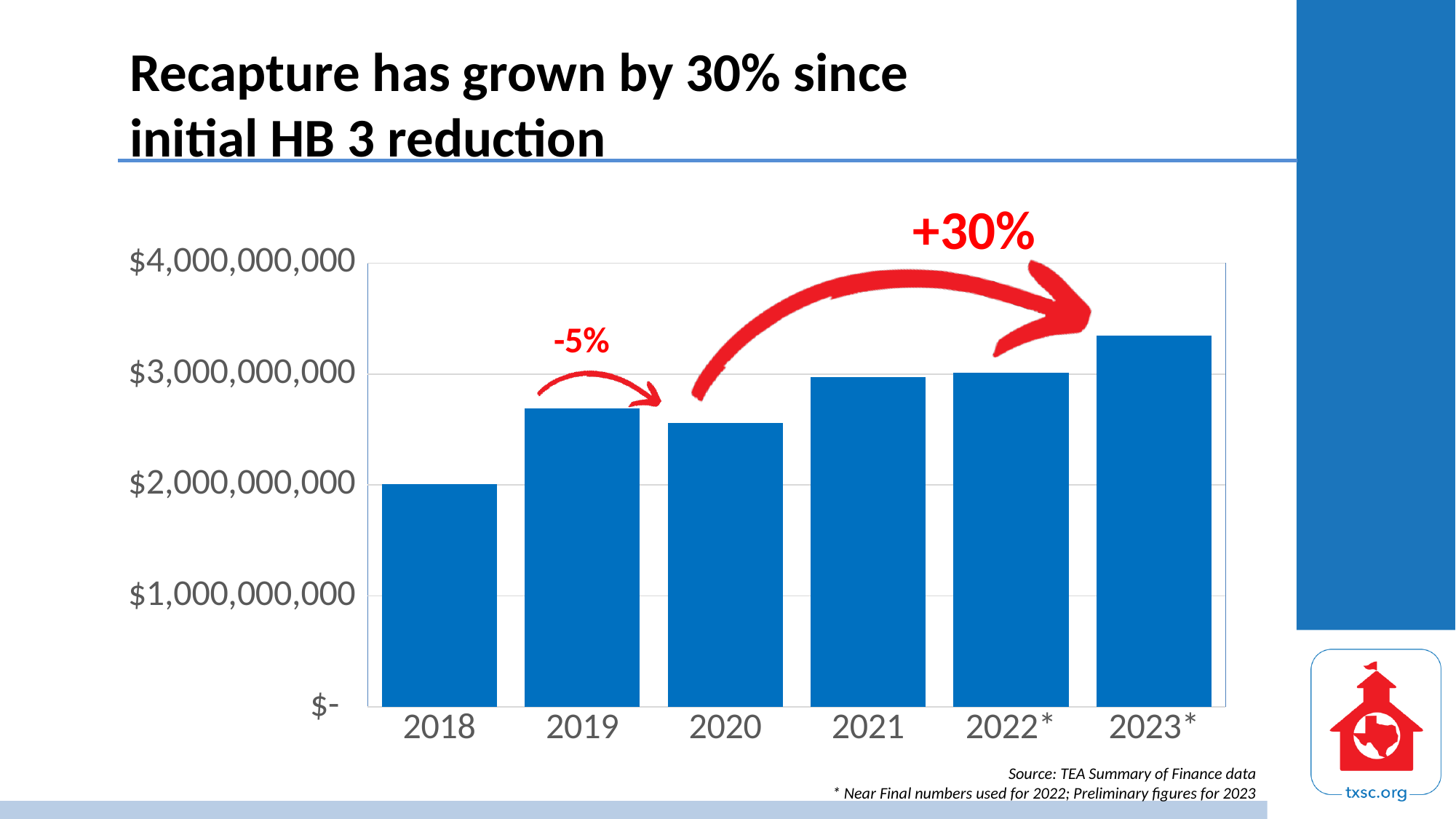
Which year has the highest bar in the chart? 2023* Which year has the larger value, 2019 or 2020? 2019 Is the value for 2020 greater or less than $3,000,000,000? less What kind of chart is shown on the slide? bar chart What percentage change is annotated in red between the 2019 and 2020 bars? -5% Is the value for 2019 greater or less than $2,000,000,000? greater Is the value for 2023* greater or less than $3,000,000,000? greater Which year has the larger value, 2018 or 2021? 2021 How many years are shown on the x axis of the chart? 6 Do the values rise or fall from 2020 to 2023*? rise Which year has the lowest bar in the chart? 2018